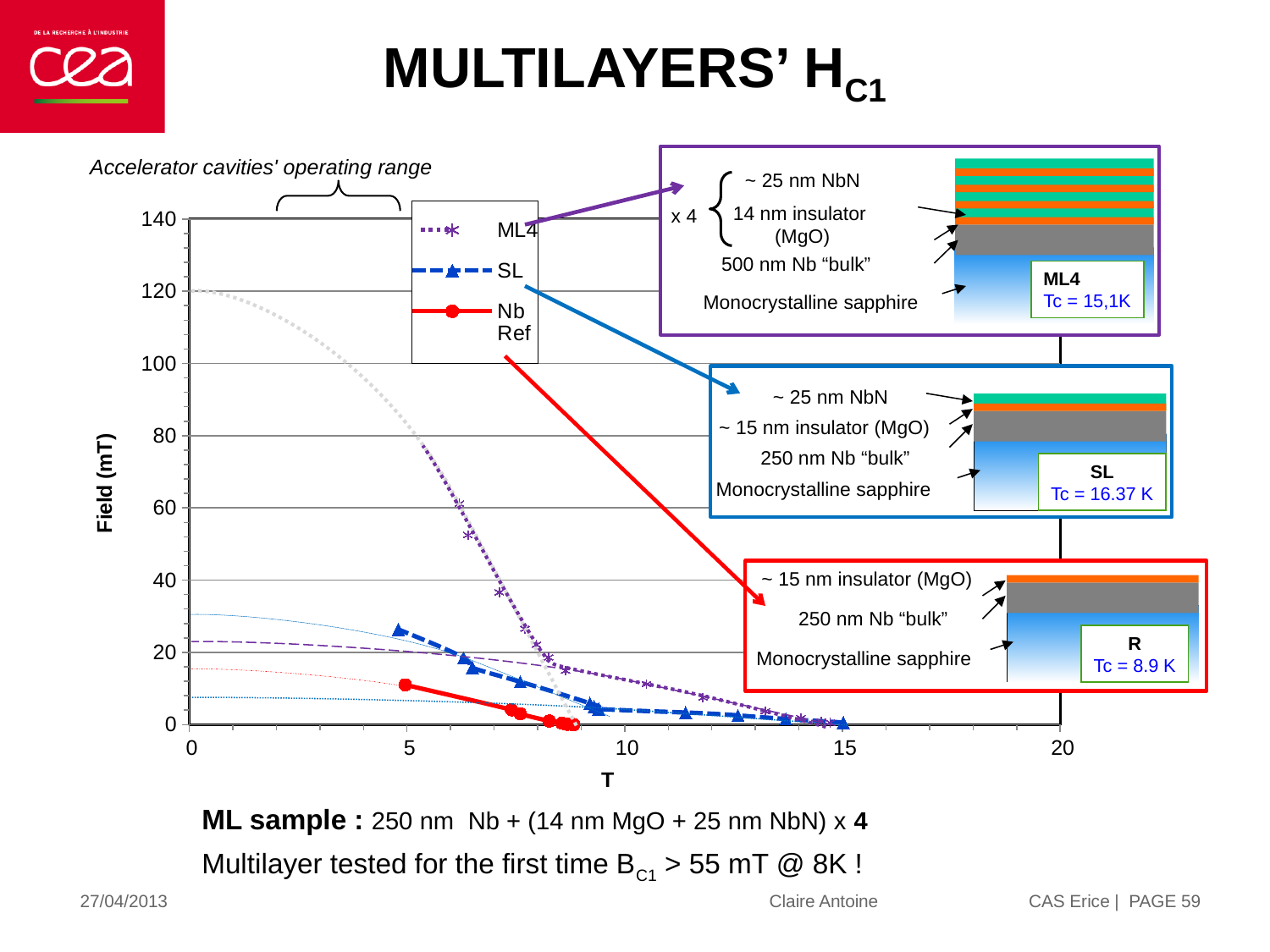
At T = 7, which series has the larger field value, ML4 or SL? ML4 Which series reaches the highest field values on the chart? ML4 How many series does the chart legend list? 3 What kind of chart is shown on the slide? line chart Do the field values rise or fall as T increases along the x axis? fall Is the value for SL at T = 5 greater or less than 40 mT? less What are the three series named in the chart legend? ML4, SL, Nb Ref Is the value for Nb Ref at T = 5 greater or less than 20 mT? less At T = 5, which series has the larger field value, SL or Nb Ref? SL What is the label of the vertical axis of the chart? Field (mT) Which series has the lowest field values on the chart? Nb Ref Is the value for ML4 at T = 7 greater or less than 60 mT? less